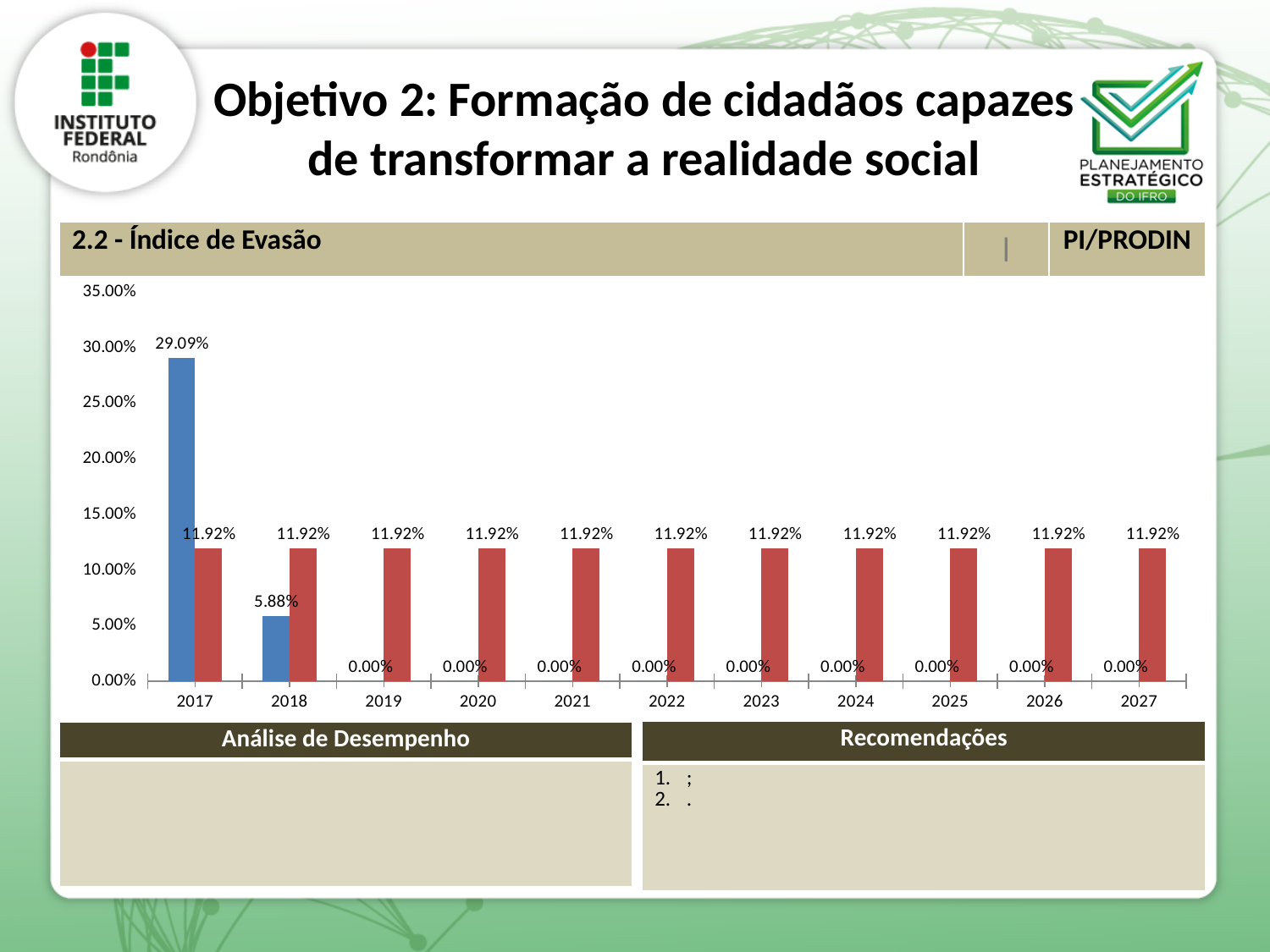
What is the value of the blue bar for 2025? 0.00% How many years are shown on the x axis? 11 What is the difference between the blue bar for 2017 and the blue bar for 2018? 23.21% What is the value of the blue bar for 2018? 5.88% What is the difference between the blue bar and the red bar for 2017? 17.17% Which year has the highest blue bar? 2017 What kind of chart is shown on the slide? bar chart For 2018, which is larger, the blue bar or the red bar? the red bar What is the value of the blue bar for 2017? 29.09% What is the value of the red bar for 2022? 11.92% Is the blue bar for 2017 greater or less than 25.00%? greater Do the blue bars rise or fall from 2017 to 2019? fall